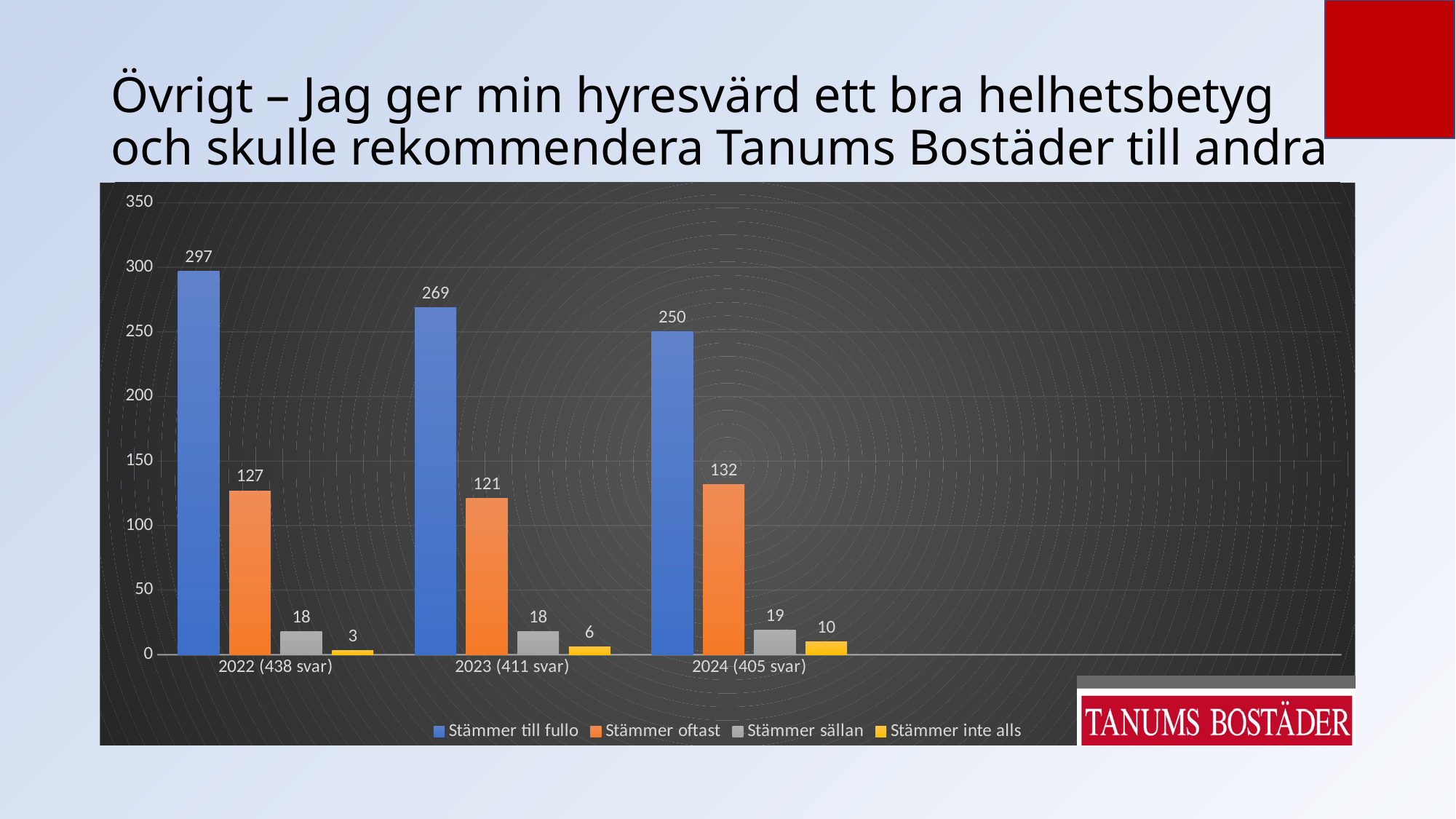
How many series does the legend list? 4 In which year is the value for 'Stämmer till fullo' highest? 2022 (438 svar) Does the value for 'Stämmer till fullo' rise or fall from 2022 to 2024? Fall How many year categories are shown on the x axis? 3 What is the value for 'Stämmer inte alls' in 2023 (411 svar)? 6 What is the difference between 'Stämmer till fullo' in 2022 (438 svar) and in 2024 (405 svar)? 47 What kind of chart is shown on the slide? Bar chart In which year is the value for 'Stämmer inte alls' lowest? 2022 (438 svar) What is the value for 'Stämmer till fullo' in 2022 (438 svar)? 297 What is the value for 'Stämmer sällan' in 2024 (405 svar)? 19 What is the value for 'Stämmer oftast' in 2024 (405 svar)? 132 Which is larger: 'Stämmer oftast' in 2022 (438 svar) or in 2023 (411 svar)? 2022 (438 svar)